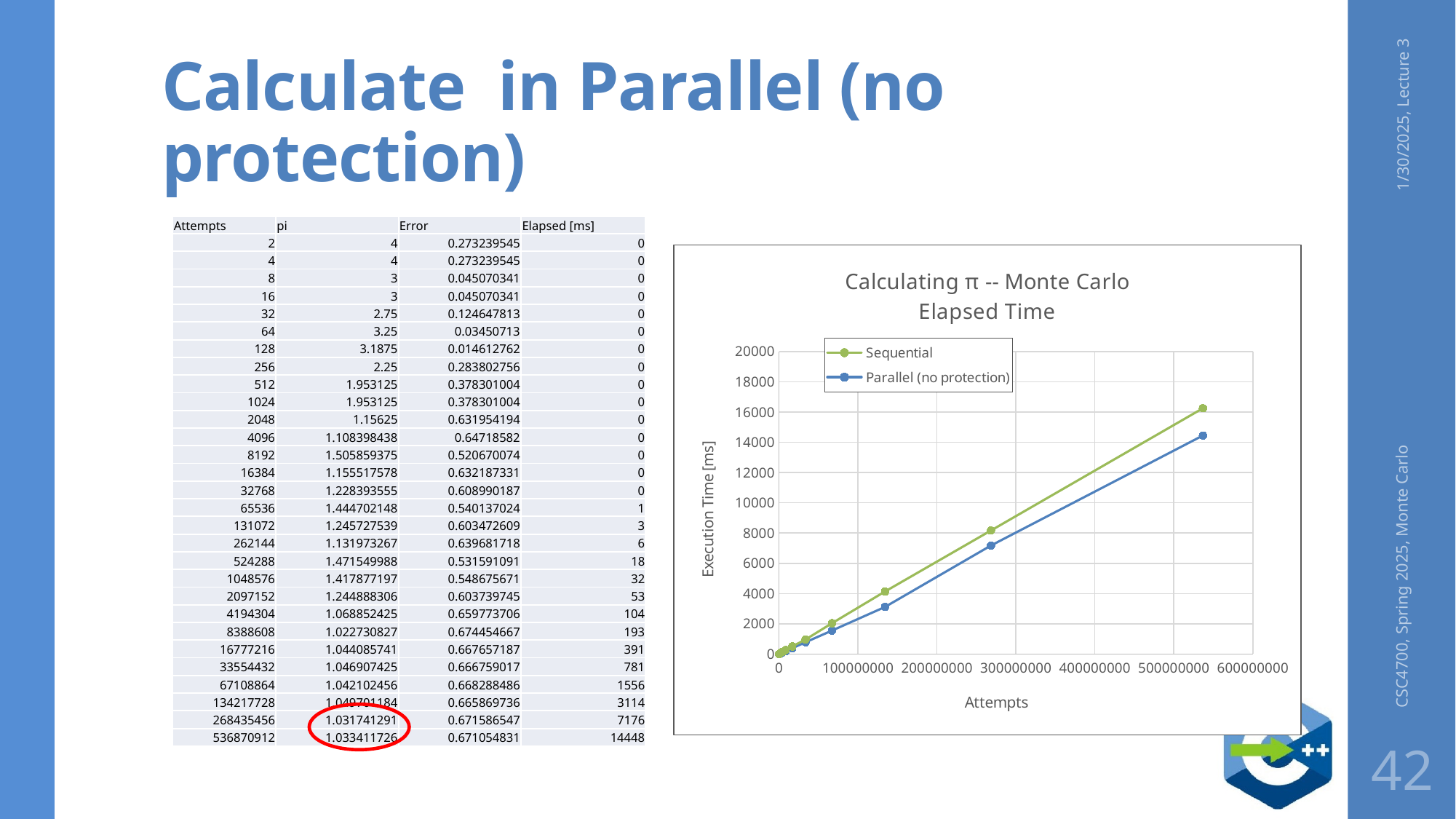
What kind of chart is shown on the slide? line chart Is the Parallel (no protection) execution time at roughly 270000000 attempts greater or less than 8000 ms? less Does execution time rise or fall as the number of attempts increases? rise Which series has the higher execution time at the largest number of attempts? Sequential What is the title of the chart? Calculating π -- Monte Carlo Elapsed Time Is the Parallel (no protection) execution time at the rightmost point greater or less than 16000 ms? less How many series does the chart legend list? 2 What is the label of the y axis of the chart? Execution Time [ms] Is the Parallel (no protection) execution time at roughly 130000000 attempts greater or less than 4000 ms? less What are the two series named in the chart legend? Sequential and Parallel (no protection) Which series has the lower execution time across the plotted attempts? Parallel (no protection)